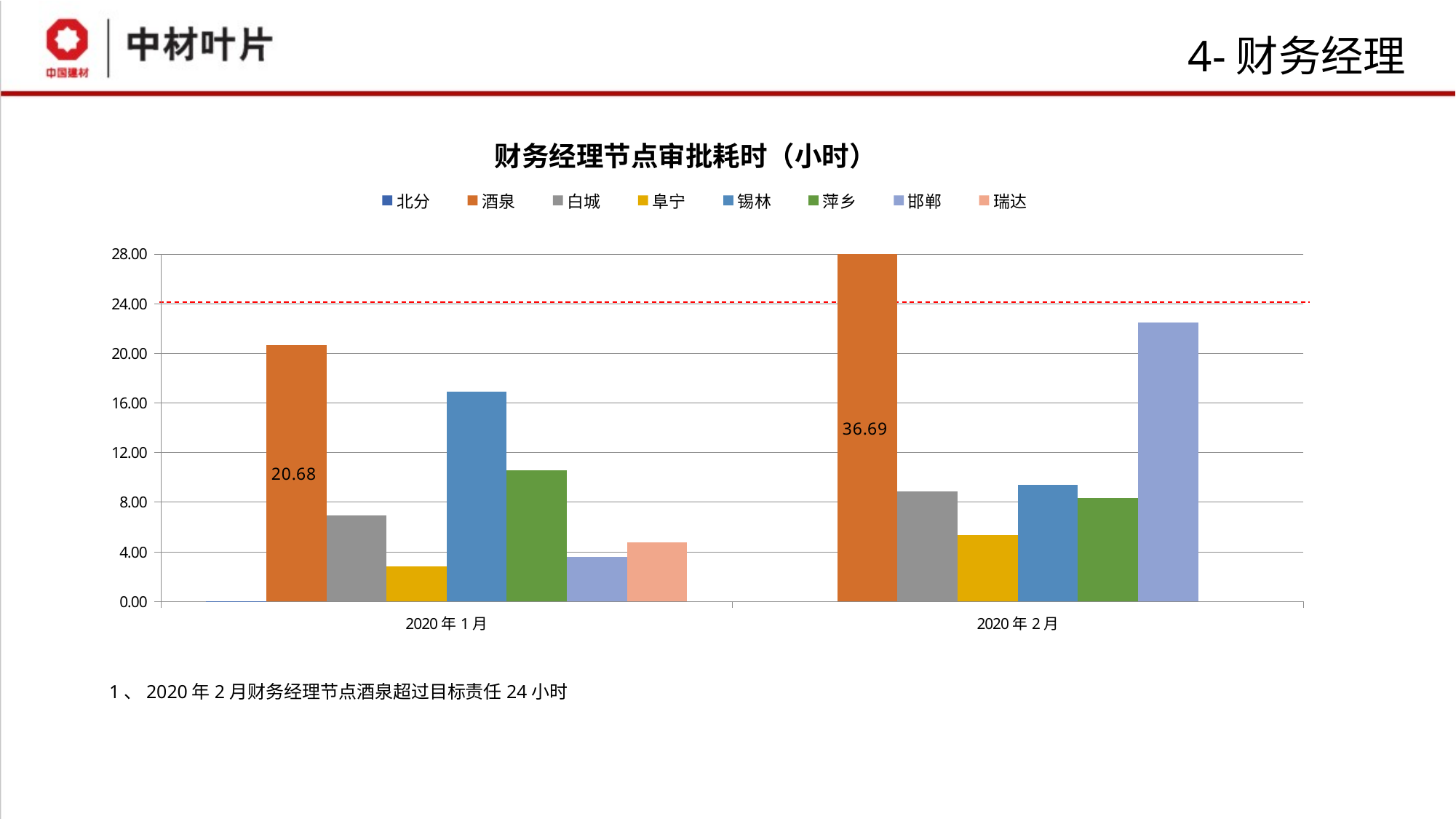
What is the difference between the 酒泉 values for 2020年2月 and 2020年1月? 16.01 Which series has the highest value in 2020年2月? 酒泉 What kind of chart is shown on the slide? bar chart Which series has the lowest value in 2020年1月? 北分 Is the value for 阜宁 in 2020年1月 greater or less than 4.00? less What is the value for 酒泉 in 2020年1月? 20.68 What is the value for 酒泉 in 2020年2月? 36.69 Which series has the highest value in 2020年1月? 酒泉 Is the value for 邯郸 in 2020年2月 greater or less than 20.00? greater How many series does the legend list? 8 How many categories are shown on the x axis? 2 Which is larger for 酒泉: the value in 2020年1月 or in 2020年2月? 2020年2月